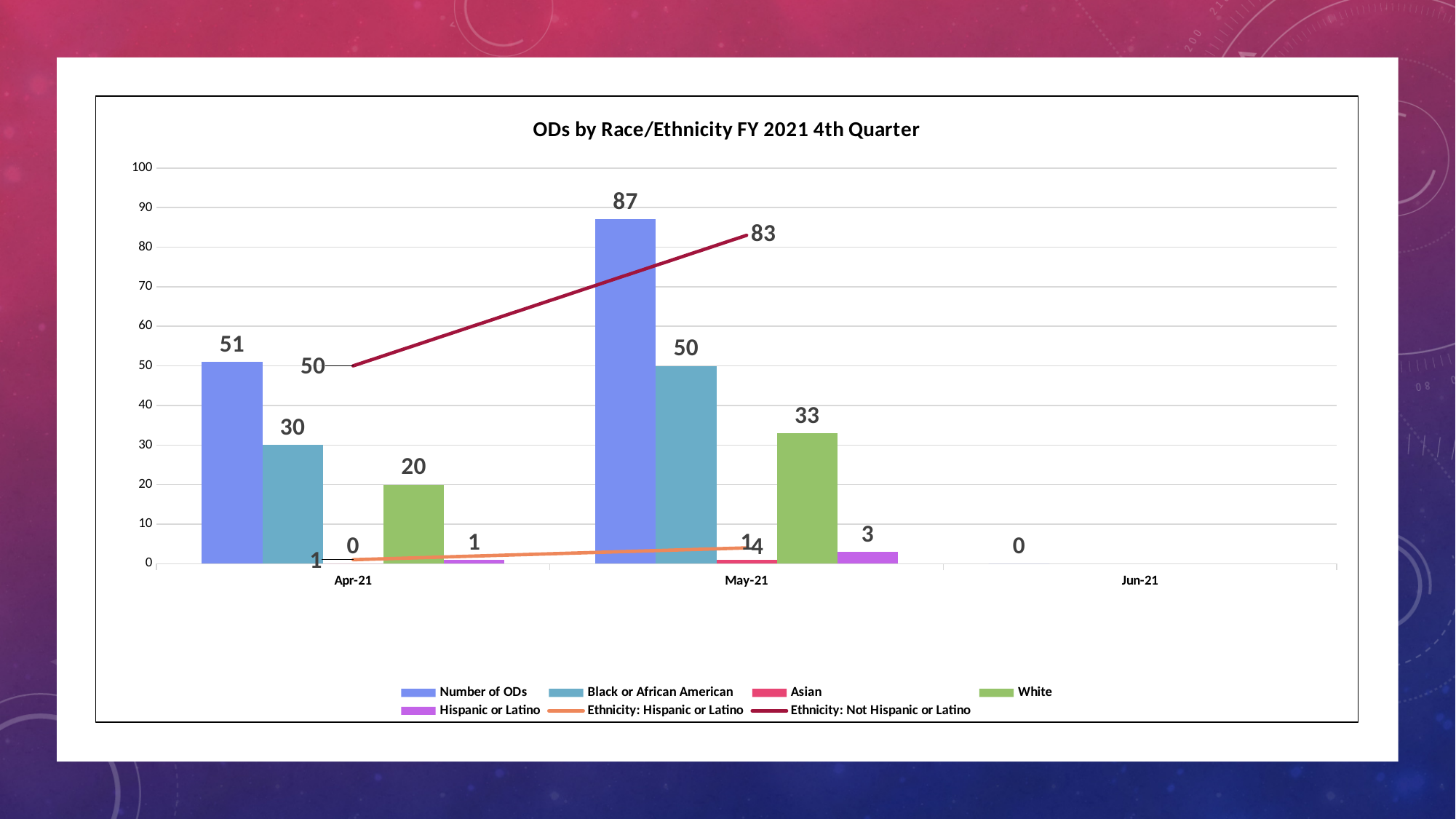
What is the value for White in Apr-21? 20 What is the difference between the Black or African American values in May-21 and Apr-21? 20 What is the Number of ODs for Apr-21? 51 How many months are shown on the x axis? 3 Does the Ethnicity: Not Hispanic or Latino line rise or fall from Apr-21 to May-21? rises What is the Number of ODs for May-21? 87 What is the difference between the Number of ODs in May-21 and Apr-21? 36 What is the value for Hispanic or Latino (bar) in May-21? 3 Which month has the higher White value, Apr-21 or May-21? May-21 What is the value of the Ethnicity: Not Hispanic or Latino line in May-21? 83 How many series does the legend list? 7 What is the value for Black or African American in May-21? 50